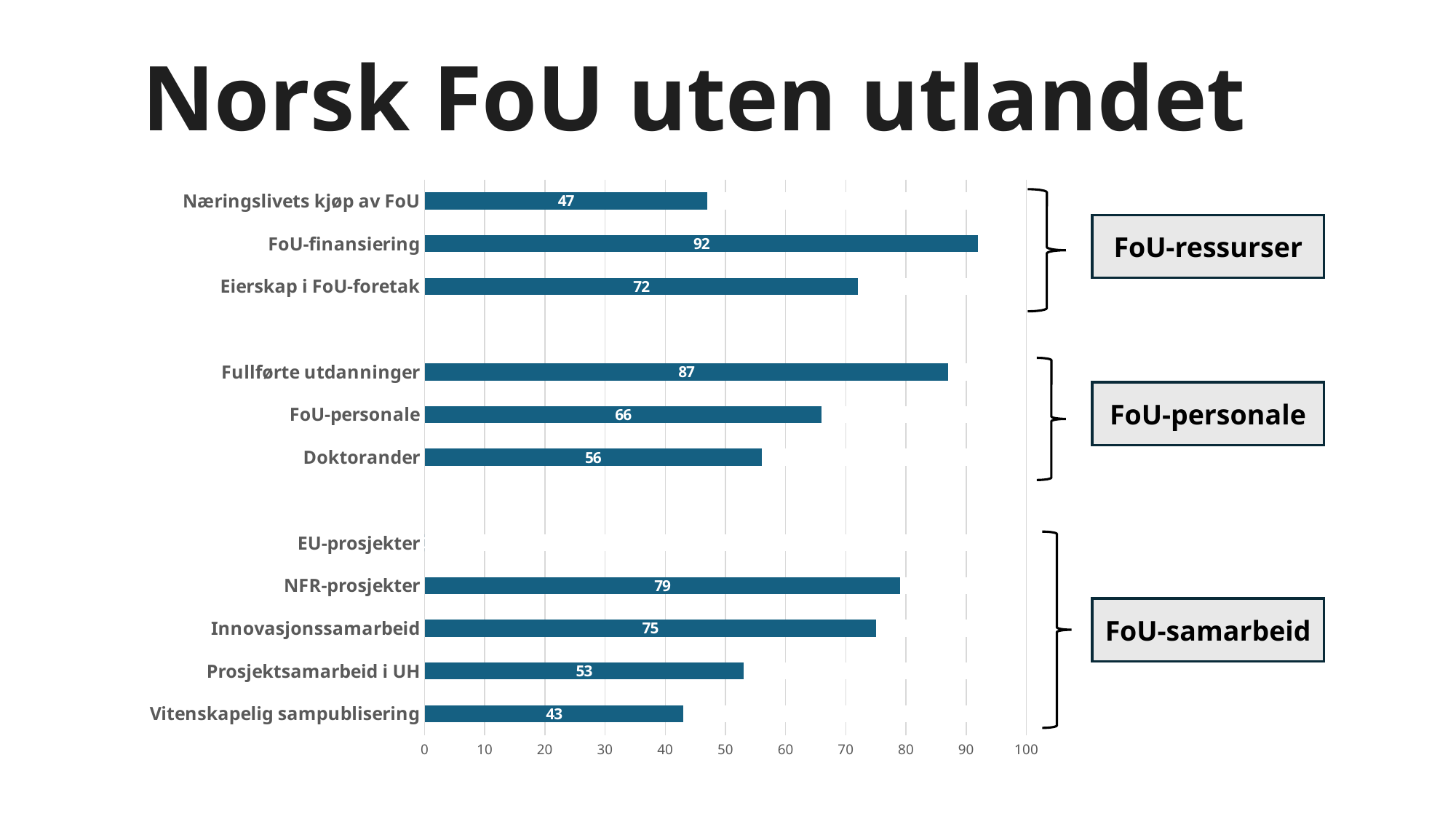
Is the value for Næringslivets kjøp av FoU greater or less than 50? less What kind of chart is shown on the slide? bar chart What is the value for FoU-finansiering? 92 Which category has the highest value? FoU-finansiering What is the value for Vitenskapelig sampublisering? 43 Which is larger, the value for Eierskap i FoU-foretak or the value for Innovasjonssamarbeid? Innovasjonssamarbeid What is the difference between the values for NFR-prosjekter and Prosjektsamarbeid i UH? 26 What is the title of the slide? Norsk FoU uten utlandet Which category label has no bar shown next to it? EU-prosjekter What is the difference between the values for Fullførte utdanninger and FoU-personale? 21 What is the value for Doktorander? 56 How many category labels are listed on the chart? 11